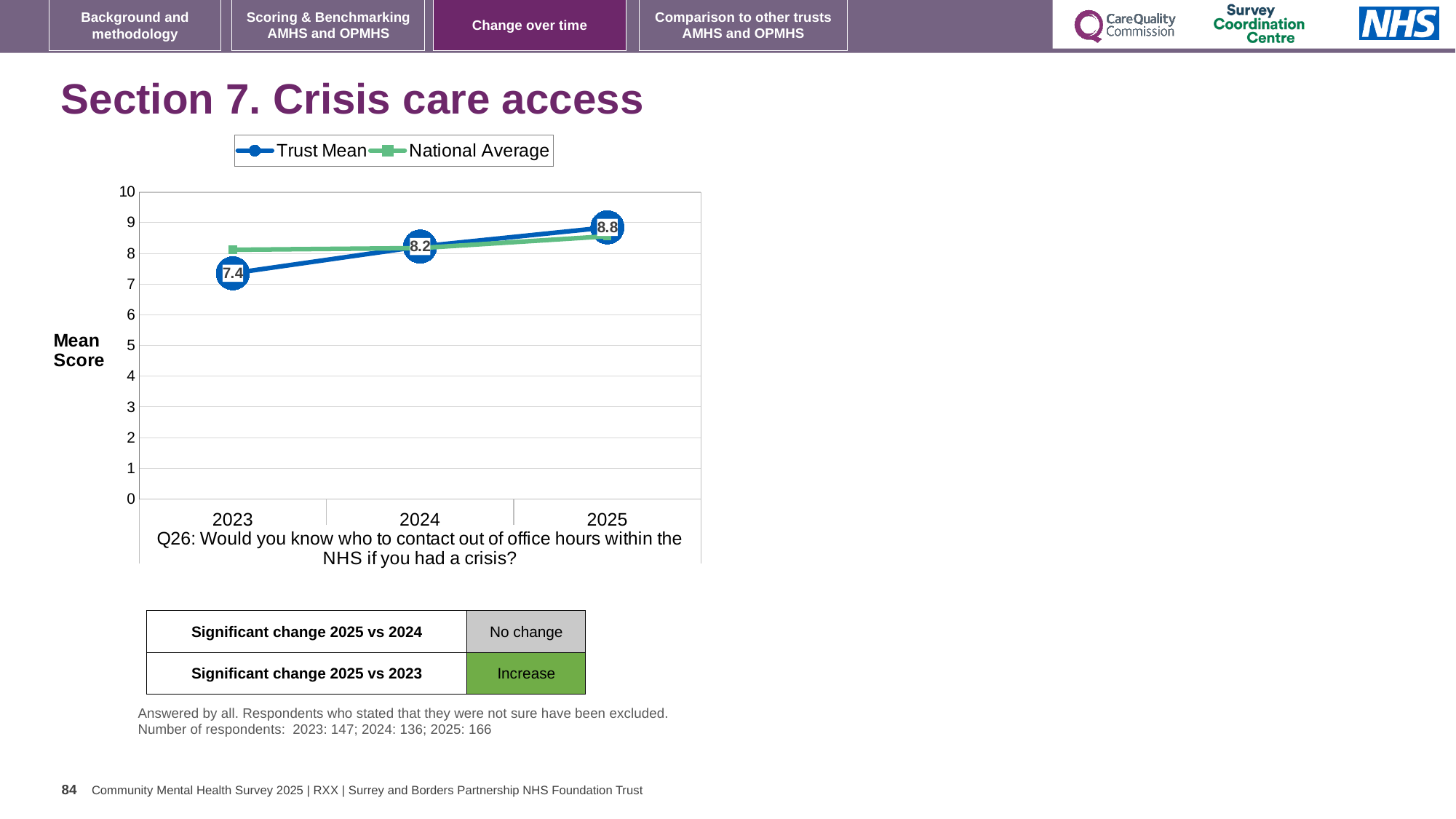
In which year is the Trust Mean score lowest? 2023 In 2023, which is higher: the Trust Mean or the National Average? National Average How many series does the legend list? 2 What is the Trust Mean score for 2023? 7.4 What is the difference between the Trust Mean scores for 2025 and 2023? 1.4 What is the Trust Mean score for 2025? 8.8 What kind of chart is shown on the slide? Line chart How many years are plotted on the x axis? 3 What is the difference between the Trust Mean scores for 2024 and 2023? 0.8 Is the National Average value for 2025 greater or less than 9? less What is the Trust Mean score for 2024? 8.2 In which year is the Trust Mean score highest? 2025